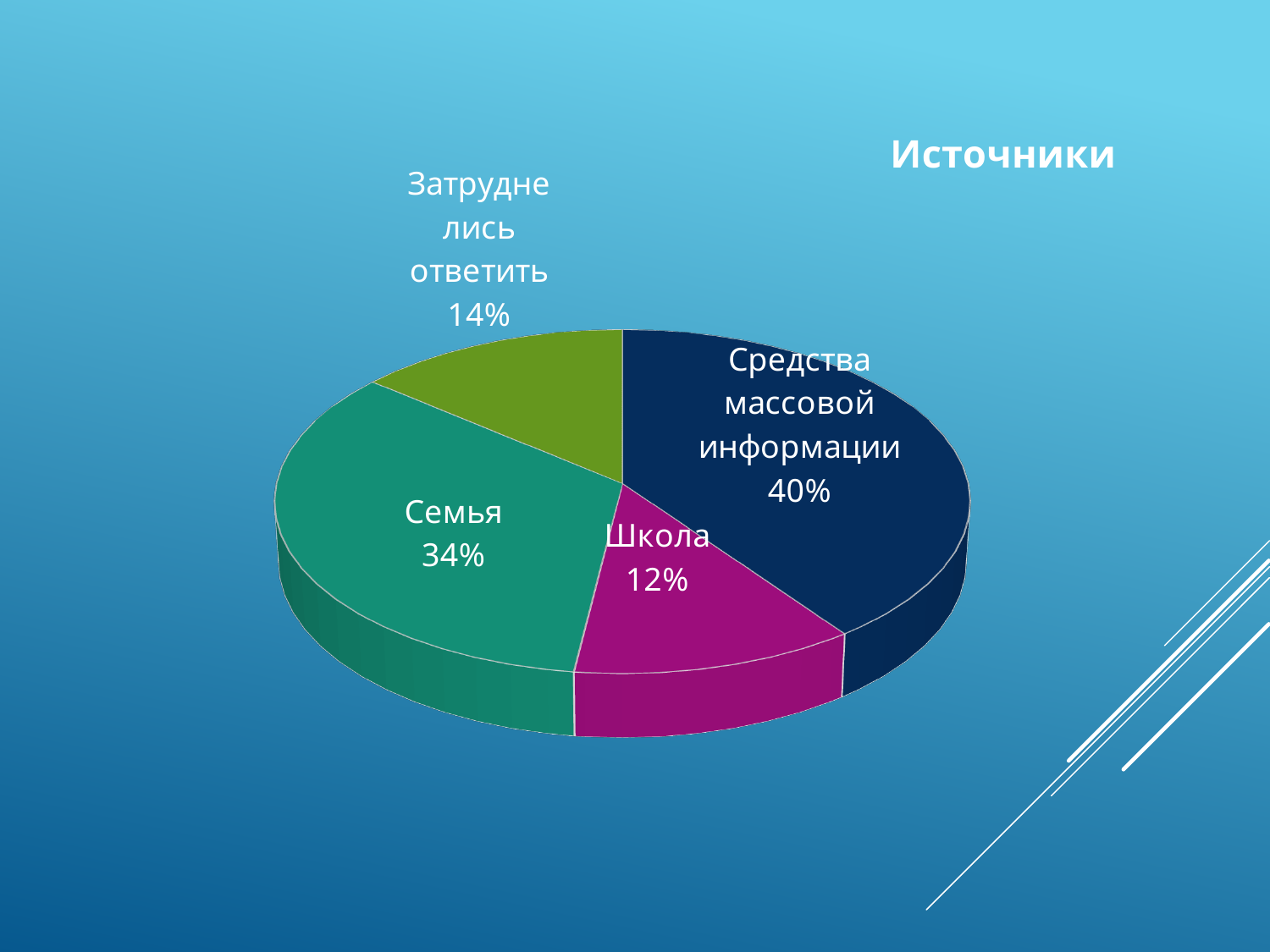
Which category has the smallest share of the pie? Школа Which category has the largest share of the pie? Средства массовой информации How many slices does the pie chart have? 4 What kind of chart is shown on the slide? pie chart What is the difference in percentage points between Средства массовой информации and Семья? 6 What colour is the slice for Школа? magenta What share of the pie is labelled Средства массовой информации? 40% What share of the pie is labelled Семья? 34% What share of the pie is labelled Затруднились ответить? 14% What is the title of the chart? Источники Which is larger, the share for Семья or the share for Затруднились ответить? Семья